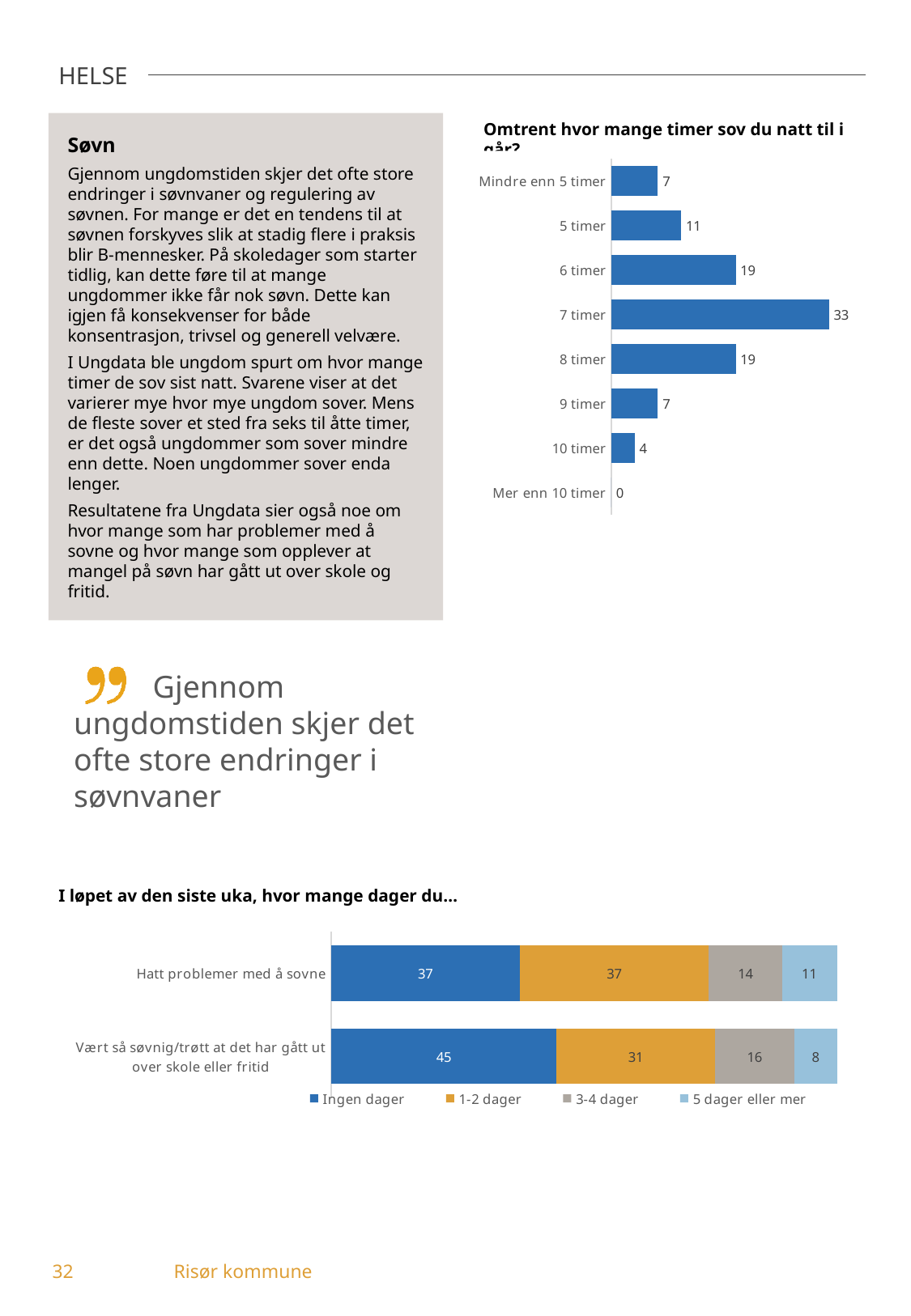
In the bottom chart 'I løpet av den siste uka, hvor mange dager du…', what is the value of '5 dager eller mer' for 'Hatt problemer med å sovne'? 11 In the chart 'Omtrent hvor mange timer sov du natt til i går?', what is the value for '10 timer'? 4 In the chart 'Omtrent hvor mange timer sov du natt til i går?', what is the value for '7 timer'? 33 In the chart 'Omtrent hvor mange timer sov du natt til i går?', what is the difference between the values for '7 timer' and '6 timer'? 14 How many series does the legend of the bottom chart 'I løpet av den siste uka, hvor mange dager du…' list? 4 In the chart 'Omtrent hvor mange timer sov du natt til i går?', how many categories are shown? 8 In the chart 'Omtrent hvor mange timer sov du natt til i går?', which category has the lowest value? Mer enn 10 timer In the chart 'Omtrent hvor mange timer sov du natt til i går?', which category has the highest value? 7 timer In the chart 'Omtrent hvor mange timer sov du natt til i går?', which is larger: the value for '5 timer' or the value for '9 timer'? 5 timer What kind of chart is the bottom chart 'I løpet av den siste uka, hvor mange dager du…'? Stacked bar chart In the bottom chart 'I løpet av den siste uka, hvor mange dager du…', what is the total of the stacked bar for 'Hatt problemer med å sovne'? 99 In the bottom chart 'I løpet av den siste uka, hvor mange dager du…', what is the value of 'Ingen dager' for 'Vært så søvnig/trøtt at det har gått ut over skole eller fritid'? 45